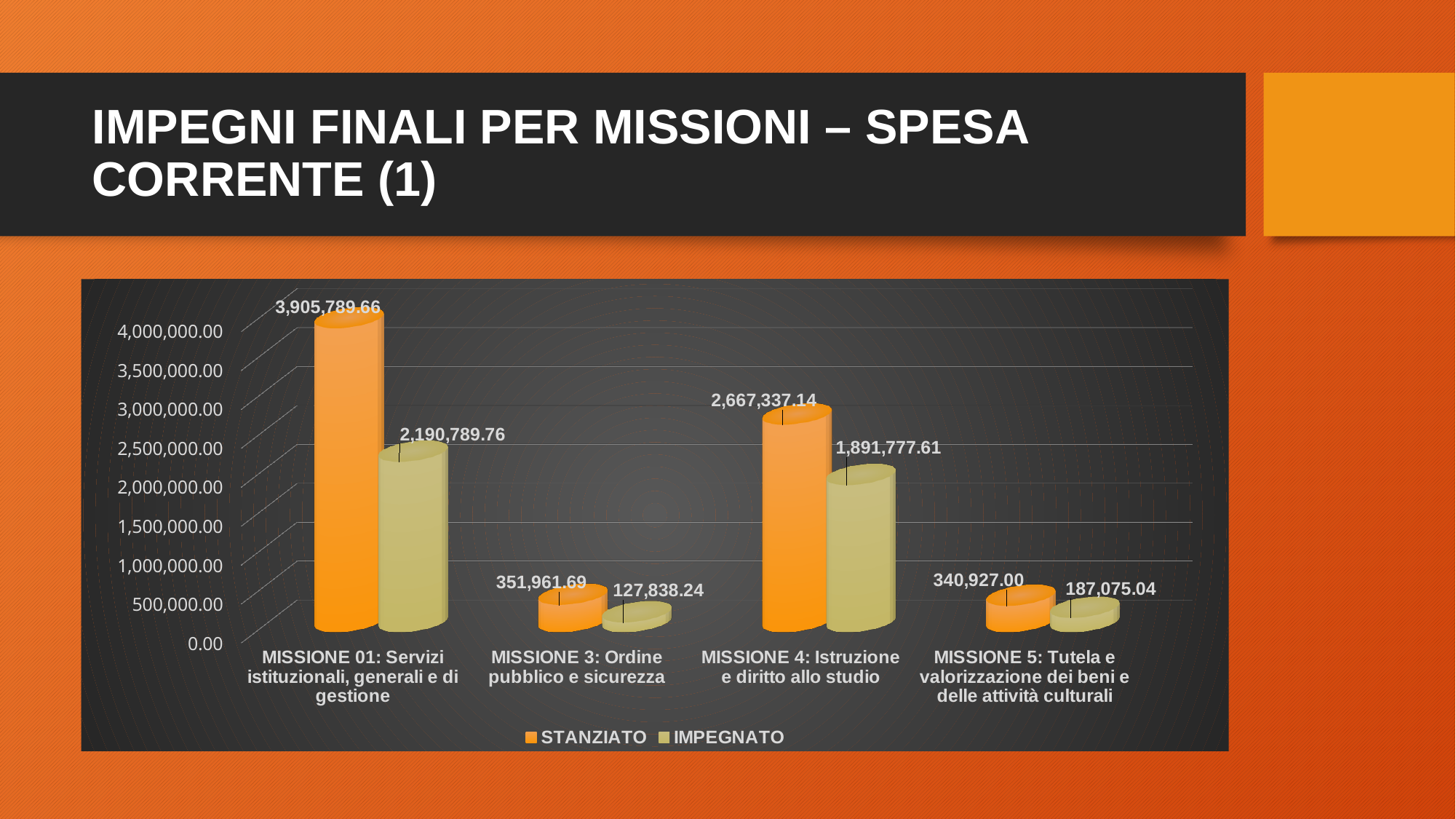
What kind of chart is shown on the slide? Bar chart How many missions (categories) are shown on the chart? 4 How many series does the legend list? 2 Which is larger: the STANZIATO value for MISSIONE 3 or the STANZIATO value for MISSIONE 5? MISSIONE 3 Which mission has the highest STANZIATO value? MISSIONE 01: Servizi istituzionali, generali e di gestione What is the STANZIATO value for MISSIONE 01: Servizi istituzionali, generali e di gestione? 3,905,789.66 What is the IMPEGNATO value for MISSIONE 3: Ordine pubblico e sicurezza? 127,838.24 What is the difference between STANZIATO and IMPEGNATO for MISSIONE 01? 1,714,999.90 What is the IMPEGNATO value for MISSIONE 4: Istruzione e diritto allo studio? 1,891,777.61 What is the STANZIATO value for MISSIONE 5: Tutela e valorizzazione dei beni e delle attività culturali? 340,927.00 What is the difference between STANZIATO and IMPEGNATO for MISSIONE 4: Istruzione e diritto allo studio? 775,559.53 Which mission has the lowest IMPEGNATO value? MISSIONE 3: Ordine pubblico e sicurezza